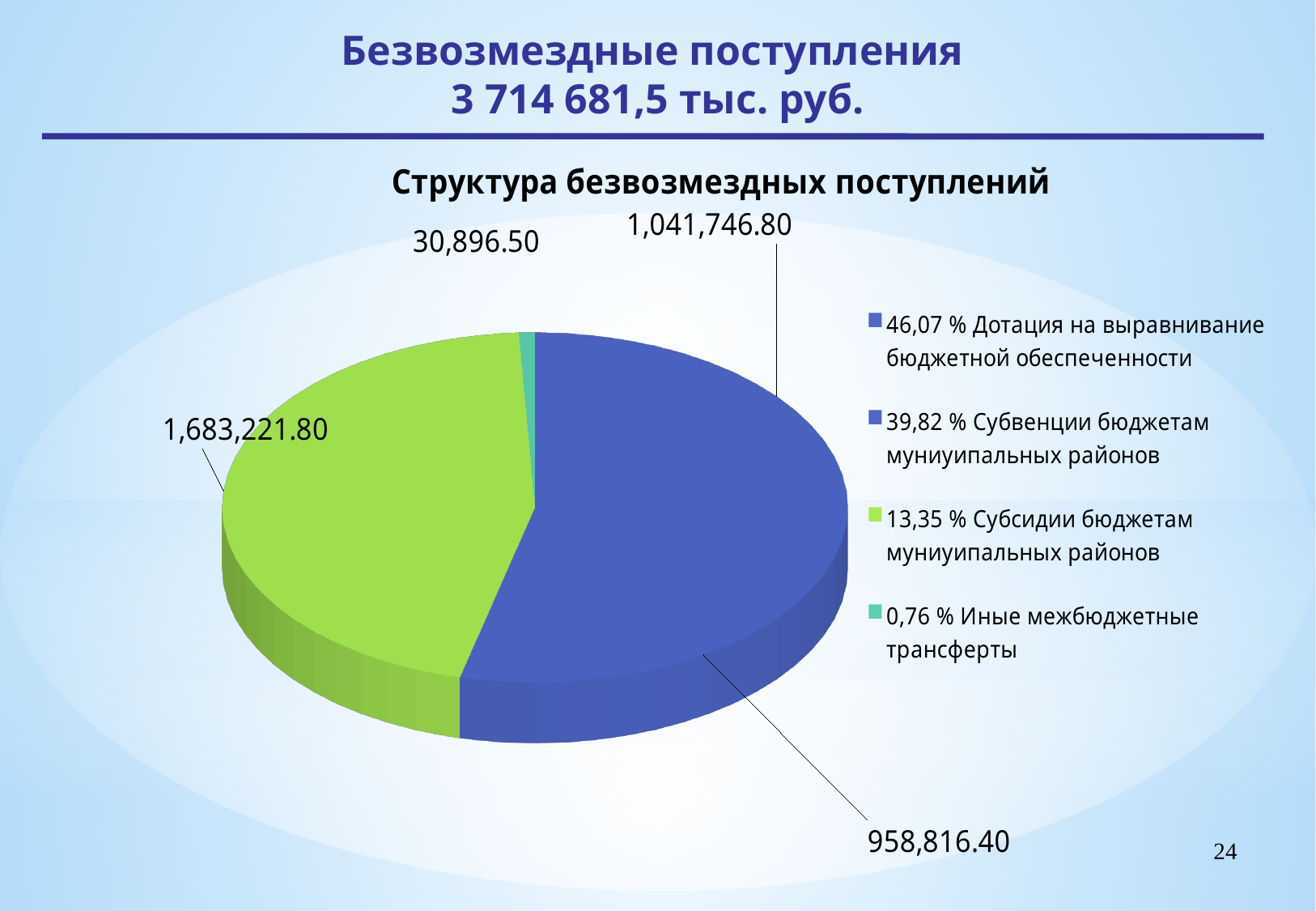
Which legend category has the largest percentage share? Дотация на выравнивание бюджетной обеспеченности What value is labeled on the green slice of the pie? 1,683,221.80 How many entries does the chart legend list? 4 What kind of chart is shown on the slide? Pie chart What is the title of the chart on the slide? Структура безвозмездных поступлений What percentage does the legend give for Дотация на выравнивание бюджетной обеспеченности? 46,07 % Which legend category has the smallest percentage share? Иные межбюджетные трансферты What percentage does the legend give for Субвенции бюджетам муниуипальных районов? 39,82 % What is the smallest data label value shown on the pie chart? 30,896.50 What percentage does the legend give for Субсидии бюджетам муниуипальных районов? 13,35 % What is the difference between the data labels 1,041,746.80 and 958,816.40? 82,930.40 What percentage does the legend give for Иные межбюджетные трансферты? 0,76 %